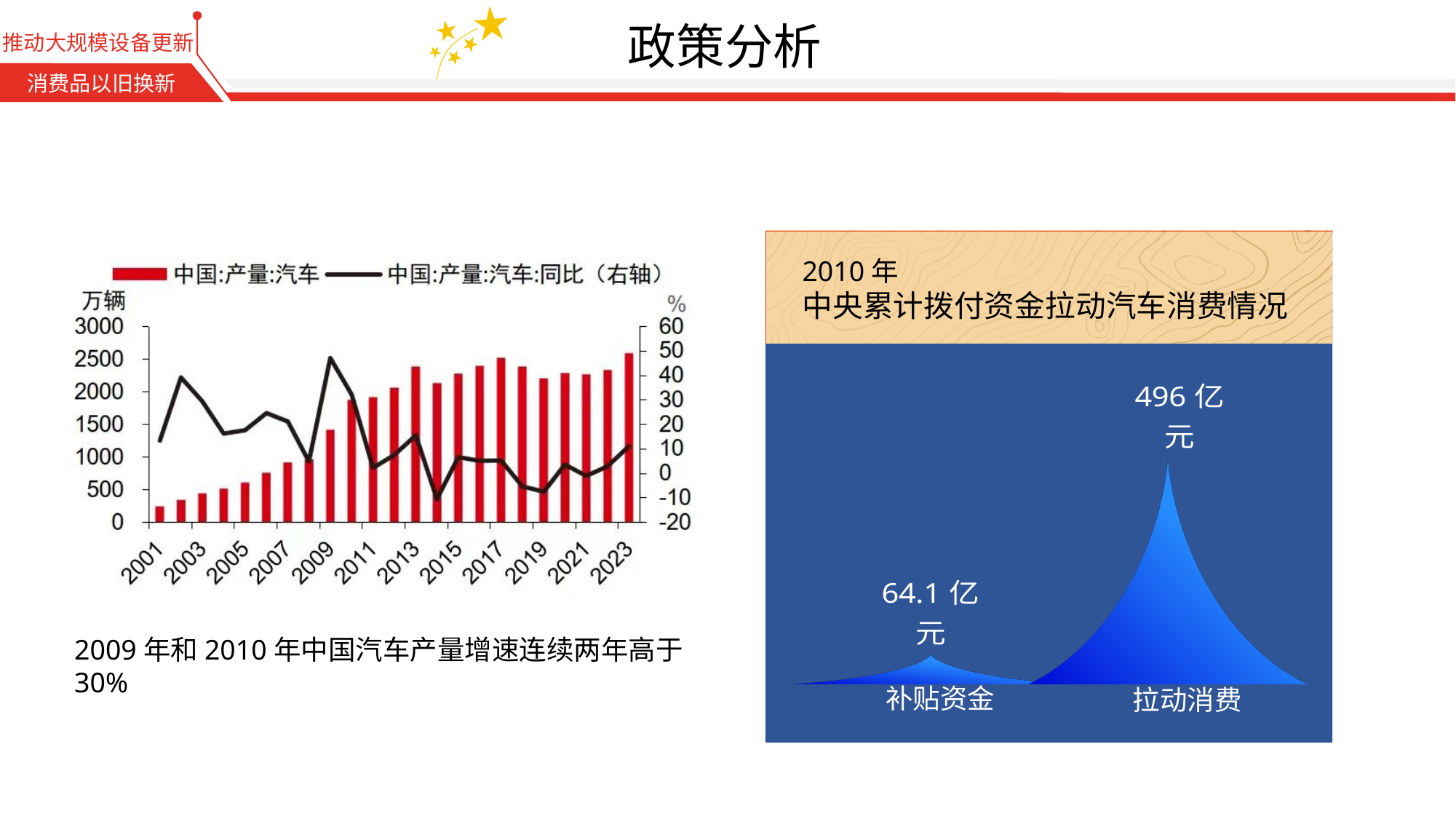
In the right chart (2010 年中央累计拨付资金拉动汽车消费情况), what is the value for 拉动消费? 496 亿元 In the left chart, is the bar value for 2017 greater or less than 2000 万辆? greater In the left chart (中国:产量:汽车), which year has the tallest bar? 2023 In the left chart, do the bar values generally rise or fall from 2001 to 2023? rise In the left chart, is the bar value for 2011 greater or less than 1500 万辆? greater What kind of chart is the left chart? A bar chart combined with a line chart In the right chart (2010 年中央累计拨付资金拉动汽车消费情况), what is the value for 补贴资金? 64.1 亿元 In the right chart, which is larger, 补贴资金 or 拉动消费? 拉动消费 In the left chart, is the 同比 (right axis) line value for 2009 greater or less than 40%? greater In the left chart, how many series does the legend list? 2 In the left chart (中国:产量:汽车), which year has the shortest bar? 2001